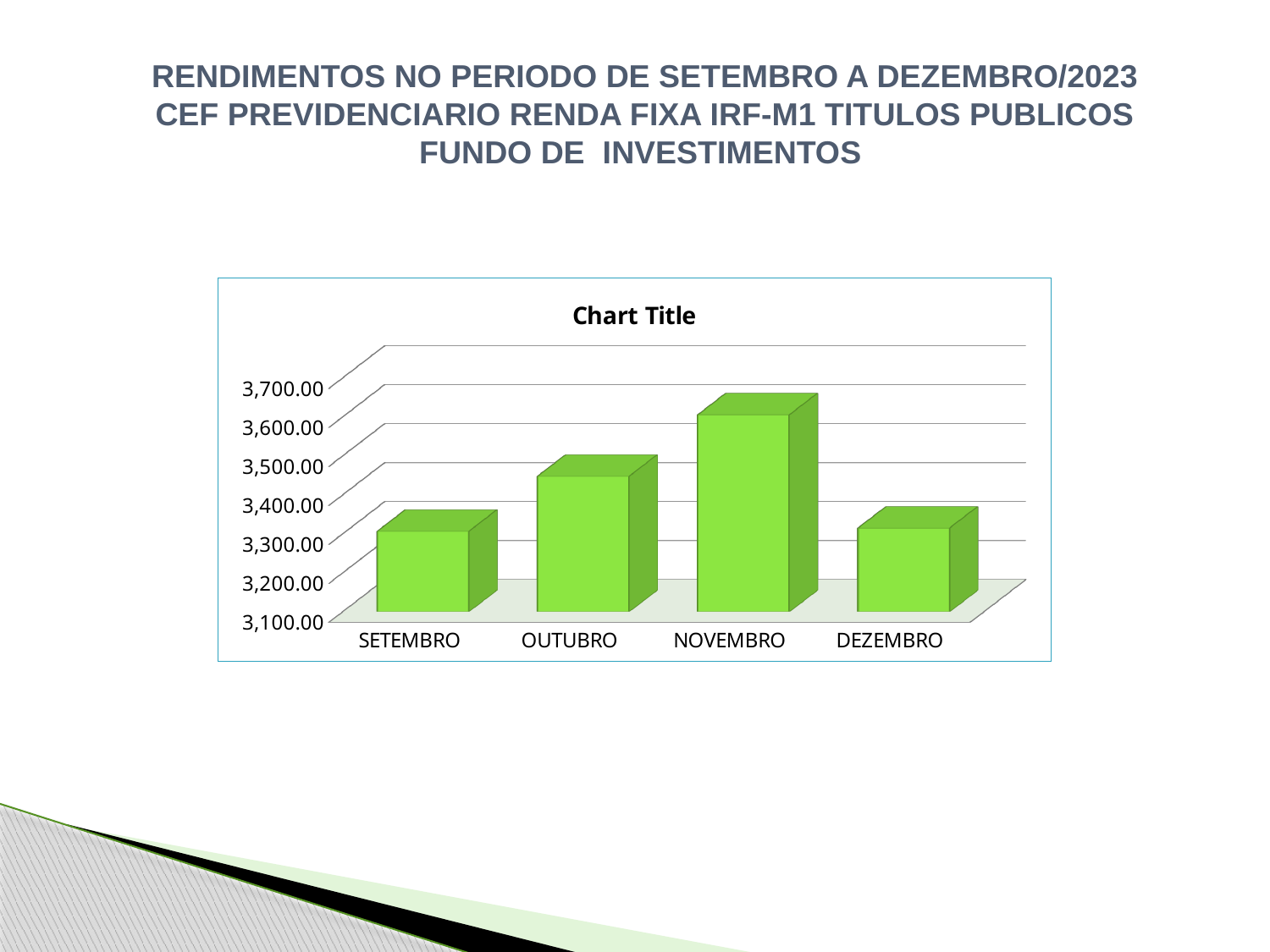
Which is larger, the value for NOVEMBRO or the value for DEZEMBRO? NOVEMBRO Is the value for OUTUBRO greater or less than 3,600.00? less Which is larger, the value for OUTUBRO or the value for SETEMBRO? OUTUBRO Do the values rise or fall from SETEMBRO to NOVEMBRO? rise What kind of chart is shown on the slide? Bar chart Is the value for DEZEMBRO greater or less than 3,500.00? less How many categories (months) are shown on the x axis of the chart? 4 Is the value for NOVEMBRO greater or less than 3,500.00? greater Which is larger, the value for NOVEMBRO or the value for OUTUBRO? NOVEMBRO What title is printed above the chart's plot area? Chart Title Which month has the highest value in the chart? NOVEMBRO